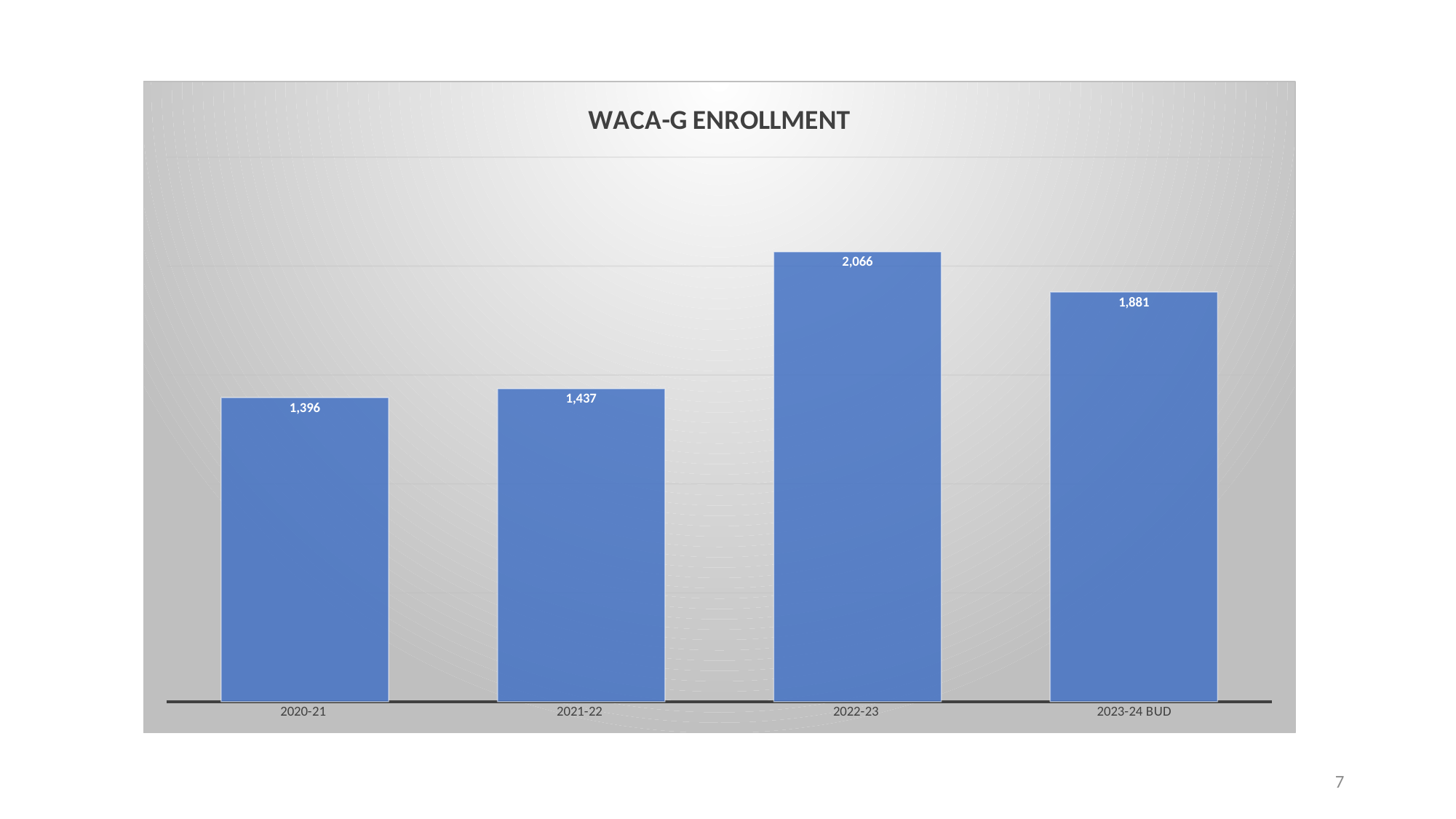
How many years (categories) are shown in the chart? 4 What is the WACA-G enrollment value for 2022-23? 2,066 What kind of chart is shown on the slide? Bar chart Which year has the lowest WACA-G enrollment? 2020-21 What is the WACA-G enrollment value for 2021-22? 1,437 What is the difference in enrollment between 2022-23 and 2023-24 BUD? 185 What is the title of the chart? WACA-G ENROLLMENT Which year has the highest WACA-G enrollment? 2022-23 Which is larger, the enrollment for 2023-24 BUD or for 2021-22? 2023-24 BUD What is the WACA-G enrollment value for 2020-21? 1,396 What is the WACA-G enrollment value for 2023-24 BUD? 1,881 What is the difference in enrollment between 2021-22 and 2020-21? 41